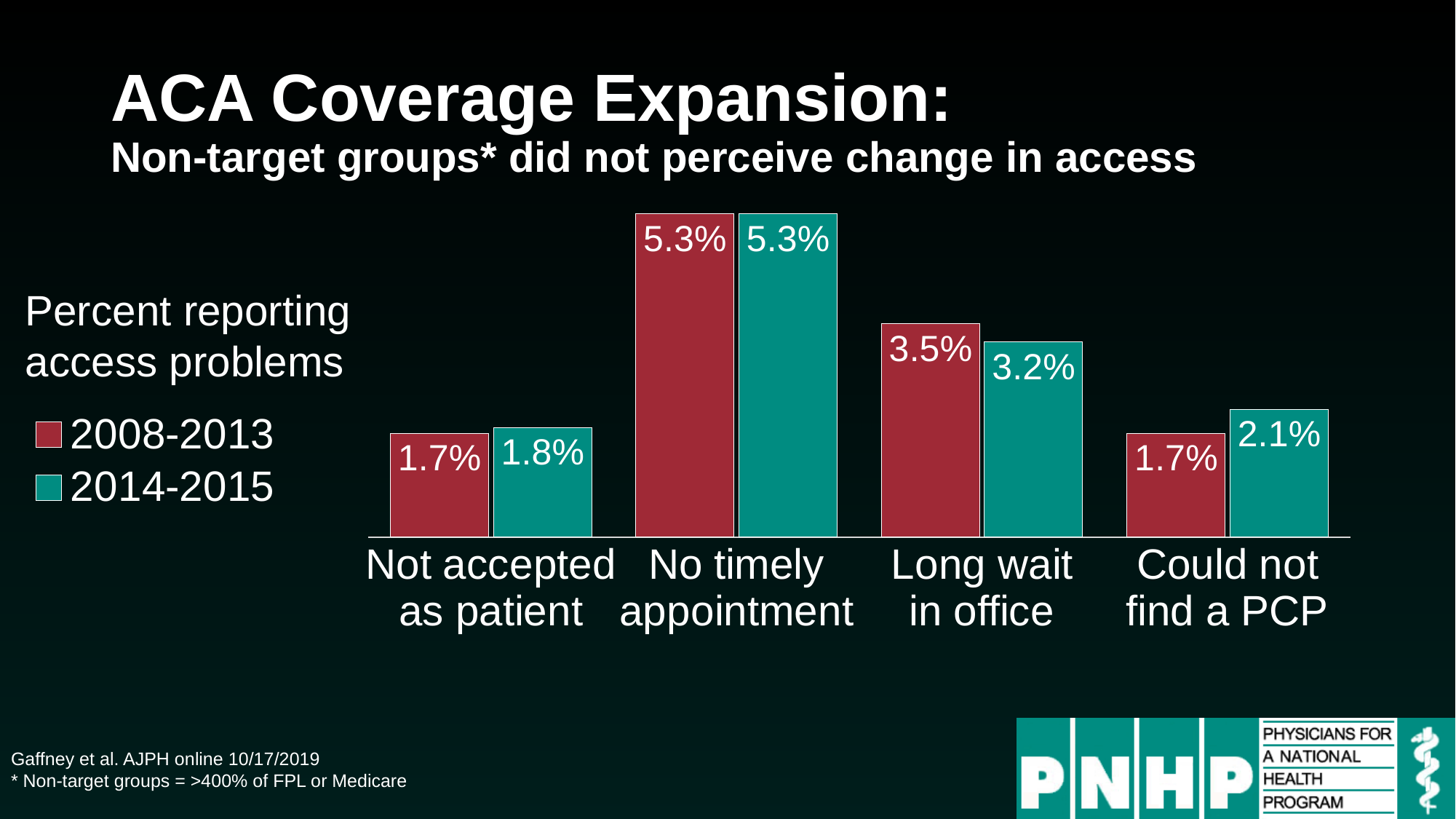
How many access problem categories are shown on the chart? 4 What percent reported 'Long wait in office' in 2014-2015? 3.2% What is the difference between the 2014-2015 and 2008-2013 values for 'Could not find a PCP'? 0.4% Which access problem has the highest percentage in the 2014-2015 series? No timely appointment What kind of chart is shown on the slide? Bar chart For 'Could not find a PCP', which period has the larger value, 2008-2013 or 2014-2015? 2014-2015 What is the difference between the 2008-2013 and 2014-2015 values for 'Long wait in office'? 0.3% What percent reported 'Could not find a PCP' in 2014-2015? 2.1% Which access problem has the lowest percentage in the 2014-2015 series? Not accepted as patient What percent reported 'Not accepted as patient' in 2008-2013? 1.7% What percent reported 'No timely appointment' in 2008-2013? 5.3% How many series does the legend list? 2